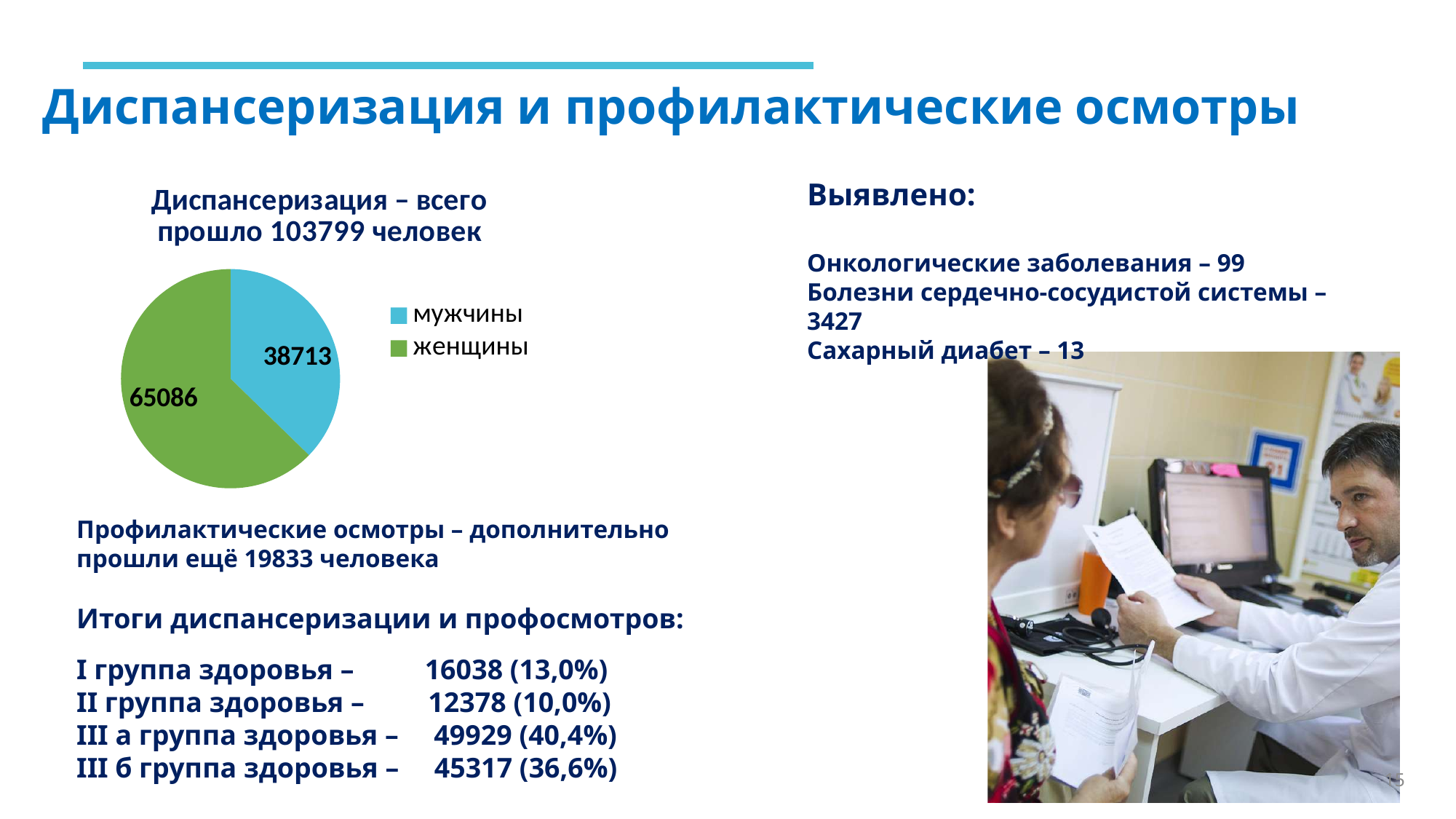
What is the difference between the values for женщины and мужчины in the pie chart? 26373 Which category has the smallest slice in the pie chart? мужчины What colour is the женщины slice in the pie chart? green What is the value for мужчины in the pie chart? 38713 What is the value for женщины in the pie chart? 65086 Which is larger in the pie chart: мужчины or женщины? женщины What share of the pie chart does the мужчины slice represent? 37.3% What kind of chart is shown on the slide? pie chart How many entries does the legend of the pie chart list? 2 How many slices does the pie chart have? 2 What is the total of the two slices in the pie chart? 103799 Which category has the largest slice in the pie chart? женщины